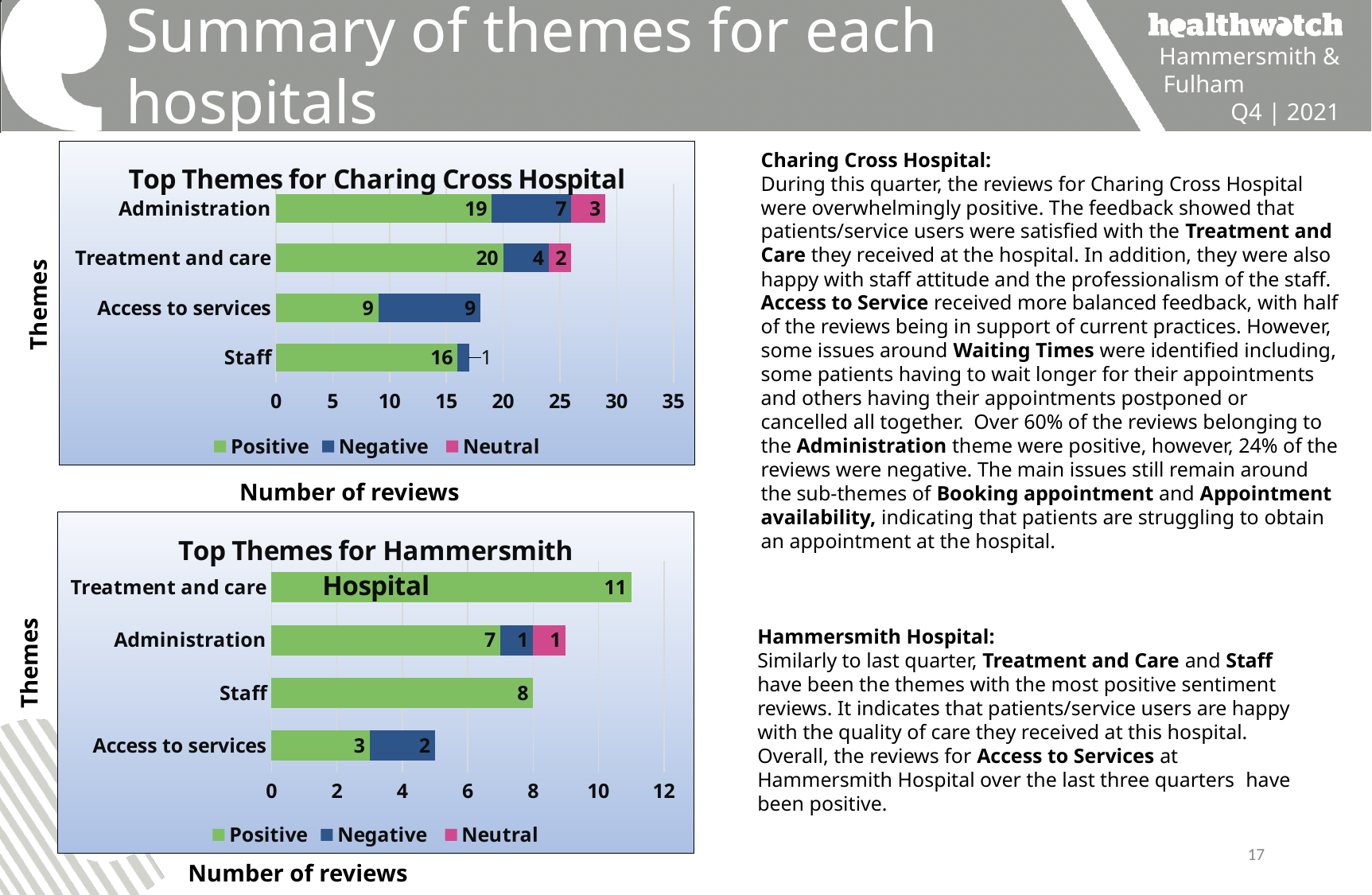
What type of chart is the Top Themes for Charing Cross Hospital chart? Stacked bar chart In the Top Themes for Charing Cross Hospital chart, what is the difference between positive and negative reviews for Access to services? 0 In the Top Themes for Hammersmith Hospital chart, how many themes are shown? 4 In the Top Themes for Charing Cross Hospital chart, which theme has the most positive reviews? Treatment and care In the Top Themes for Charing Cross Hospital chart, how many negative reviews does Administration have? 7 In the Top Themes for Hammersmith Hospital chart, which theme has the fewest positive reviews? Access to services In the Top Themes for Hammersmith Hospital chart, how many positive reviews does Treatment and care have? 11 In the Top Themes for Hammersmith Hospital chart, which has more positive reviews, Staff or Administration? Staff In the Top Themes for Charing Cross Hospital chart, how many series does the legend list? 3 In the Top Themes for Hammersmith Hospital chart, what is the total number of reviews for Administration? 9 In the Top Themes for Charing Cross Hospital chart, what is the total number of reviews for Administration? 29 In the Top Themes for Charing Cross Hospital chart, how many positive reviews does Treatment and care have? 20